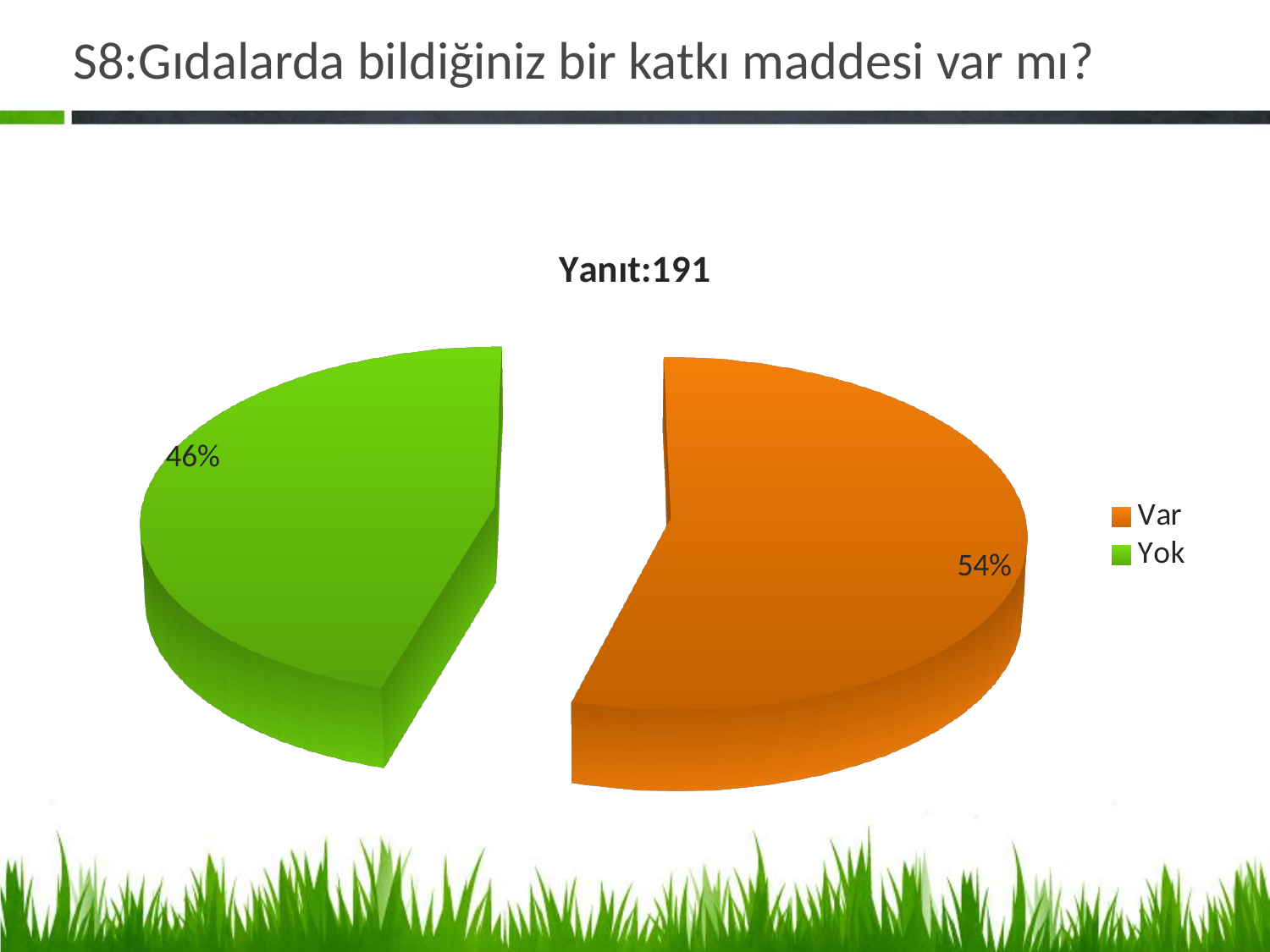
What colour is the "Yok" slice? Green What share of the pie does "Yok" represent? 46% How many slices does the pie chart have? 2 Is the share for "Var" greater or less than 50%? greater What share of the pie does "Var" represent? 54% What kind of chart is shown on the slide? Pie chart Which category has the largest slice of the pie? Var Which slice is larger, "Var" or "Yok"? Var What is the difference in percentage points between the "Var" and "Yok" slices? 8 percentage points Is the share for "Yok" greater or less than 50%? less What is the title of the chart? Yanıt:191 Which category has the smallest slice of the pie? Yok